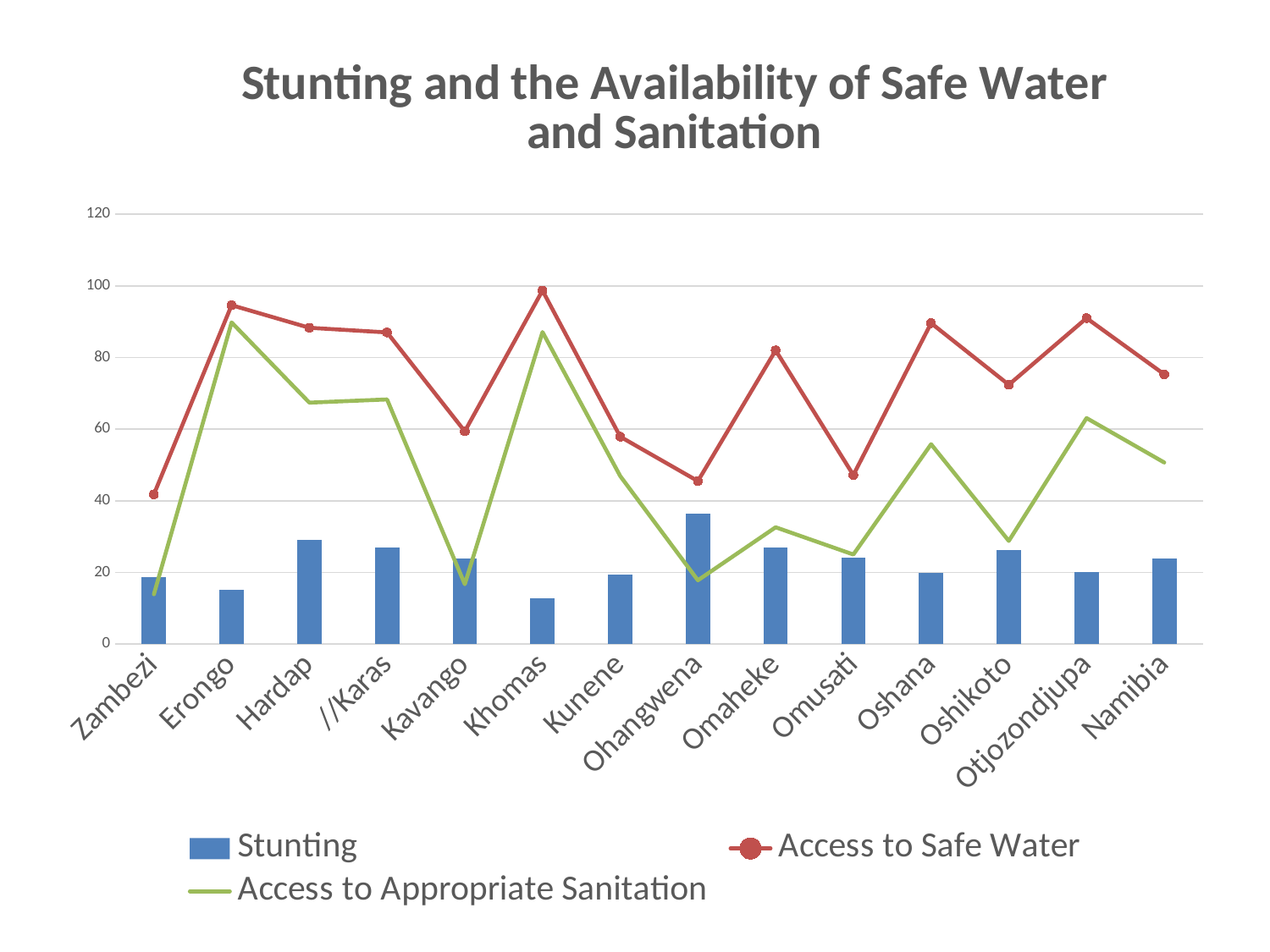
Which region has the lowest value for Access to Safe Water? Zambezi Which has the larger Access to Safe Water value, Erongo or Kavango? Erongo Which region has the highest value for Access to Safe Water? Khomas What is the title of the chart? Stunting and the Availability of Safe Water and Sanitation Is the Access to Appropriate Sanitation value for Kavango greater or less than 40? less How many regions (categories) are shown on the x axis? 14 Which region has the lowest Stunting value? Khomas Is the Stunting value for Ohangwena greater or less than 20? greater Which region has the highest Stunting value? Ohangwena What kind of chart is shown on the slide? Combined bar and line chart Is the Access to Safe Water value for Khomas greater or less than 80? greater How many series does the legend list? 3